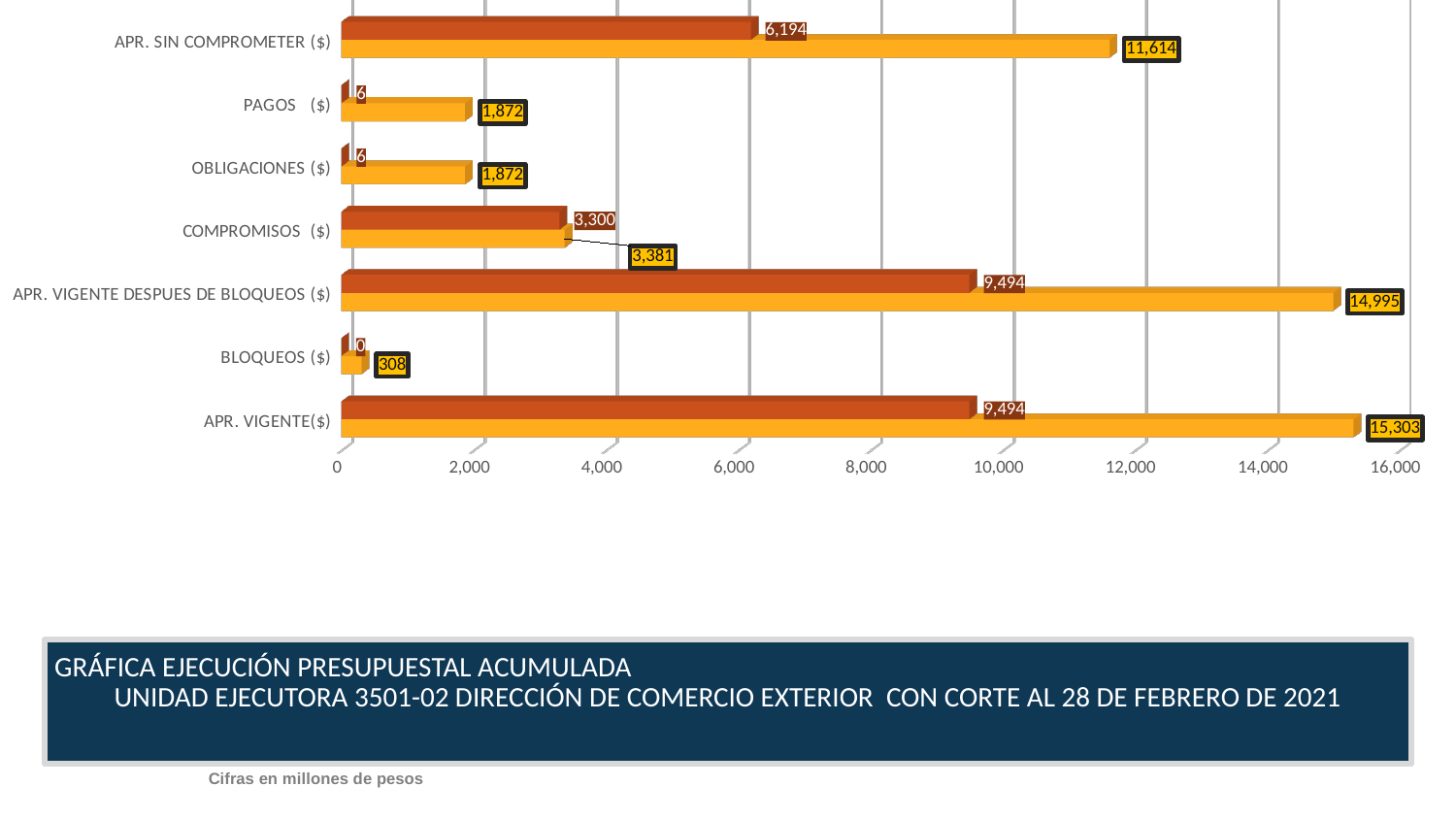
Which category has the highest yellow bar value? APR. VIGENTE($) What is the value of the yellow bar for COMPROMISOS ($)? 3,381 How many categories are shown on the chart? 7 What is the difference between the yellow bar values for APR. VIGENTE($) and APR. VIGENTE DESPUES DE BLOQUEOS ($)? 308 Which category has the lowest dark orange bar value? BLOQUEOS ($) What is the value of the yellow bar for BLOQUEOS ($)? 308 Is the yellow bar value for APR. SIN COMPROMETER ($) greater or less than 10,000? greater What is the difference between the yellow and dark orange bar values for APR. SIN COMPROMETER ($)? 5,420 What is the value of the dark orange bar for APR. SIN COMPROMETER ($)? 6,194 What is the value of the yellow bar for APR. VIGENTE($)? 15,303 What type of chart is shown on the slide? Bar chart Which is larger, the yellow bar for PAGOS ($) or the yellow bar for COMPROMISOS ($)? COMPROMISOS ($)